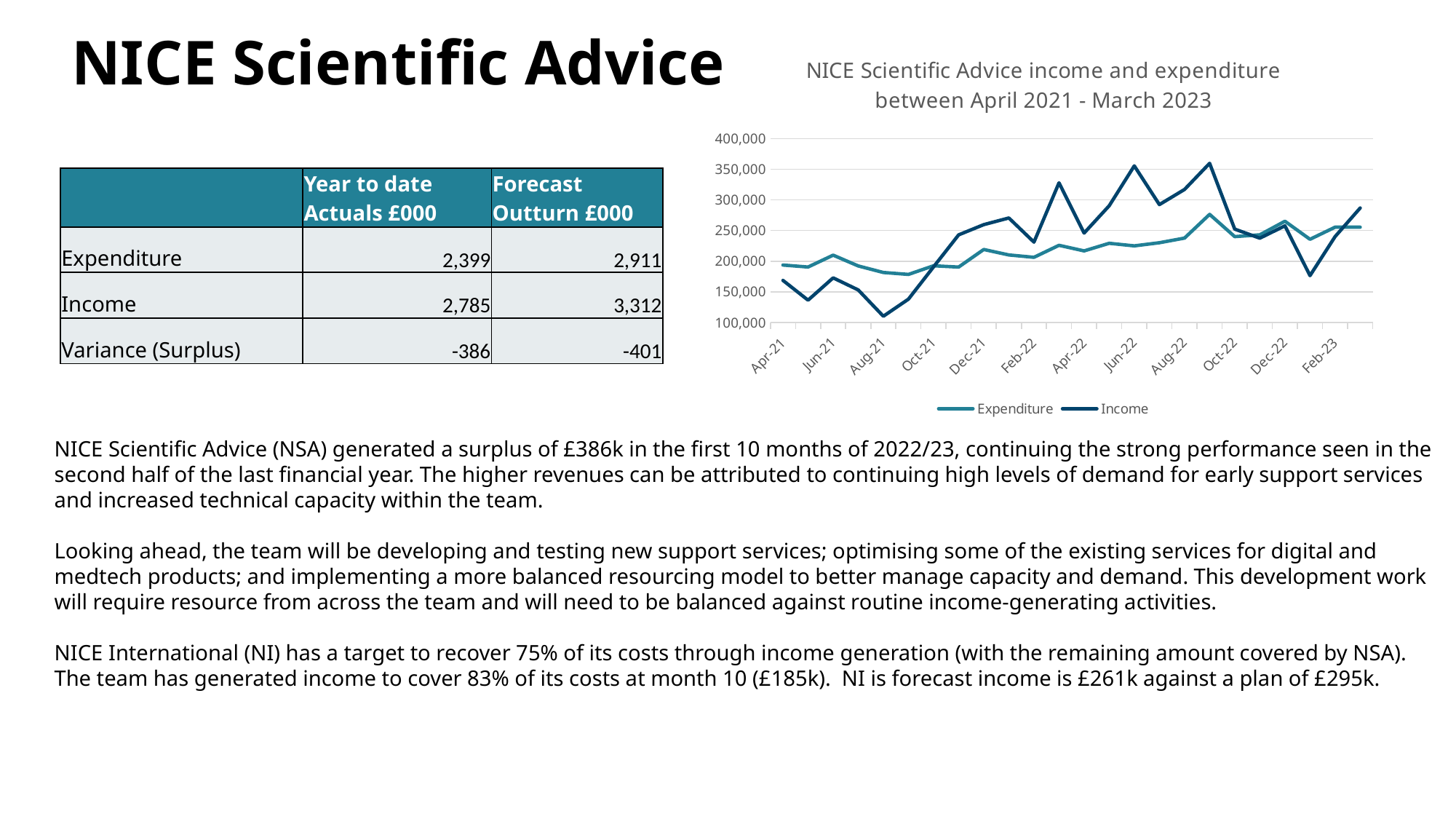
Is the Income value for Apr-21 greater or less than 200,000? less How many month labels are shown on the x axis of the chart? 12 Is the Income value for Aug-21 greater or less than 150,000? less What kind of chart is shown on the slide? Line chart Is the Income value for Jun-22 greater or less than 300,000? greater What is the title of the chart? NICE Scientific Advice income and expenditure between April 2021 - March 2023 How many series does the chart's legend list? 2 At Apr-21, which series has the higher value, Expenditure or Income? Expenditure At Jun-22, which series has the higher value, Expenditure or Income? Income What are the two series named in the chart's legend? Expenditure and Income